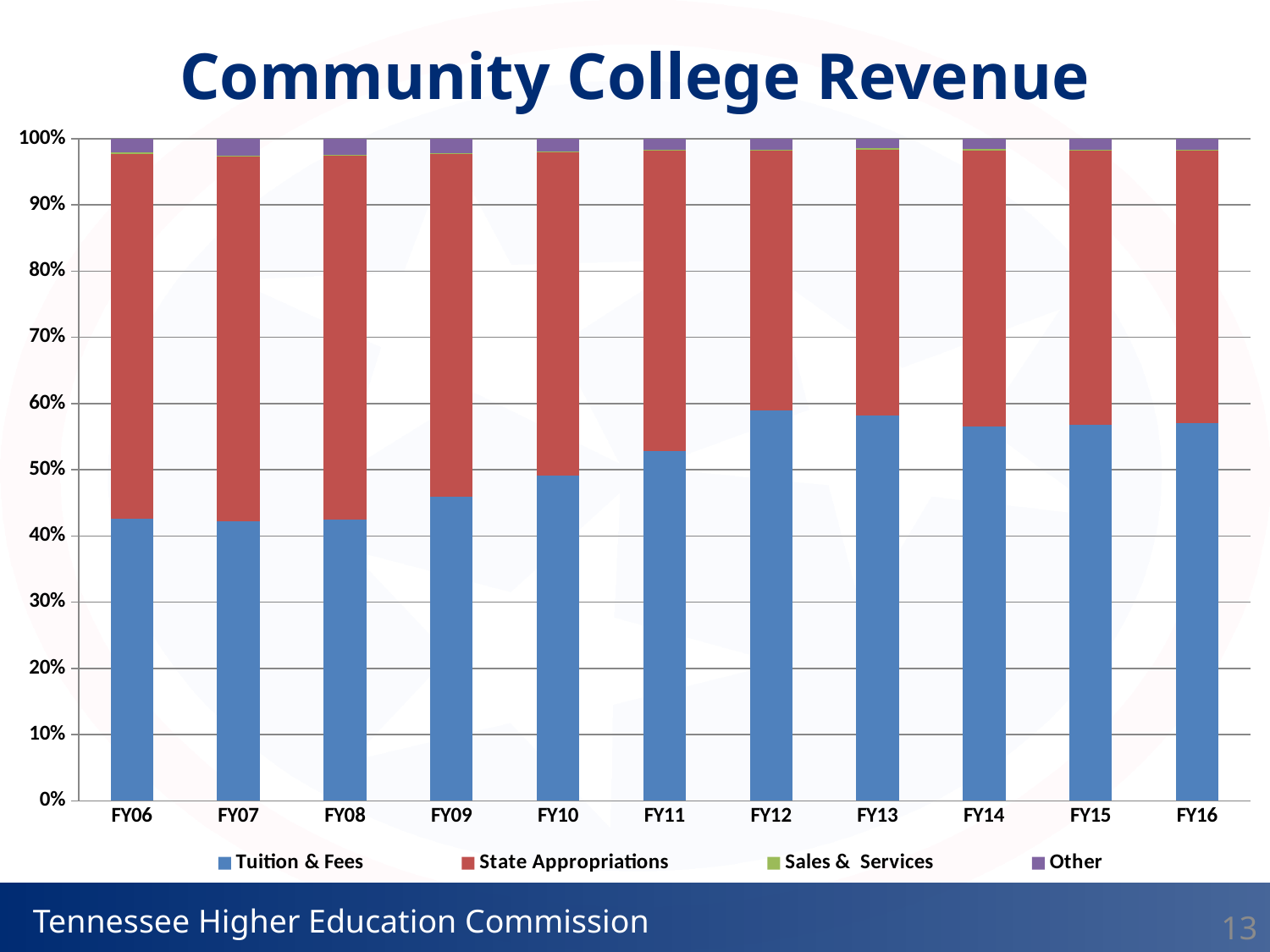
Is the Tuition & Fees share for FY12 greater or less than 60%? less Is the Tuition & Fees share for FY09 greater or less than 50%? less Does the Tuition & Fees share generally rise or fall from FY06 to FY16? rise Which year has a larger Tuition & Fees share, FY06 or FY12? FY12 How many series does the legend list? 4 Is the Tuition & Fees share for FY11 greater or less than 50%? greater What is the title of the chart? Community College Revenue How many fiscal years are shown on the x axis? 11 Which year has a larger State Appropriations share, FY06 or FY16? FY06 Which series is shown in blue? Tuition & Fees What kind of chart is shown on the slide? Stacked bar chart